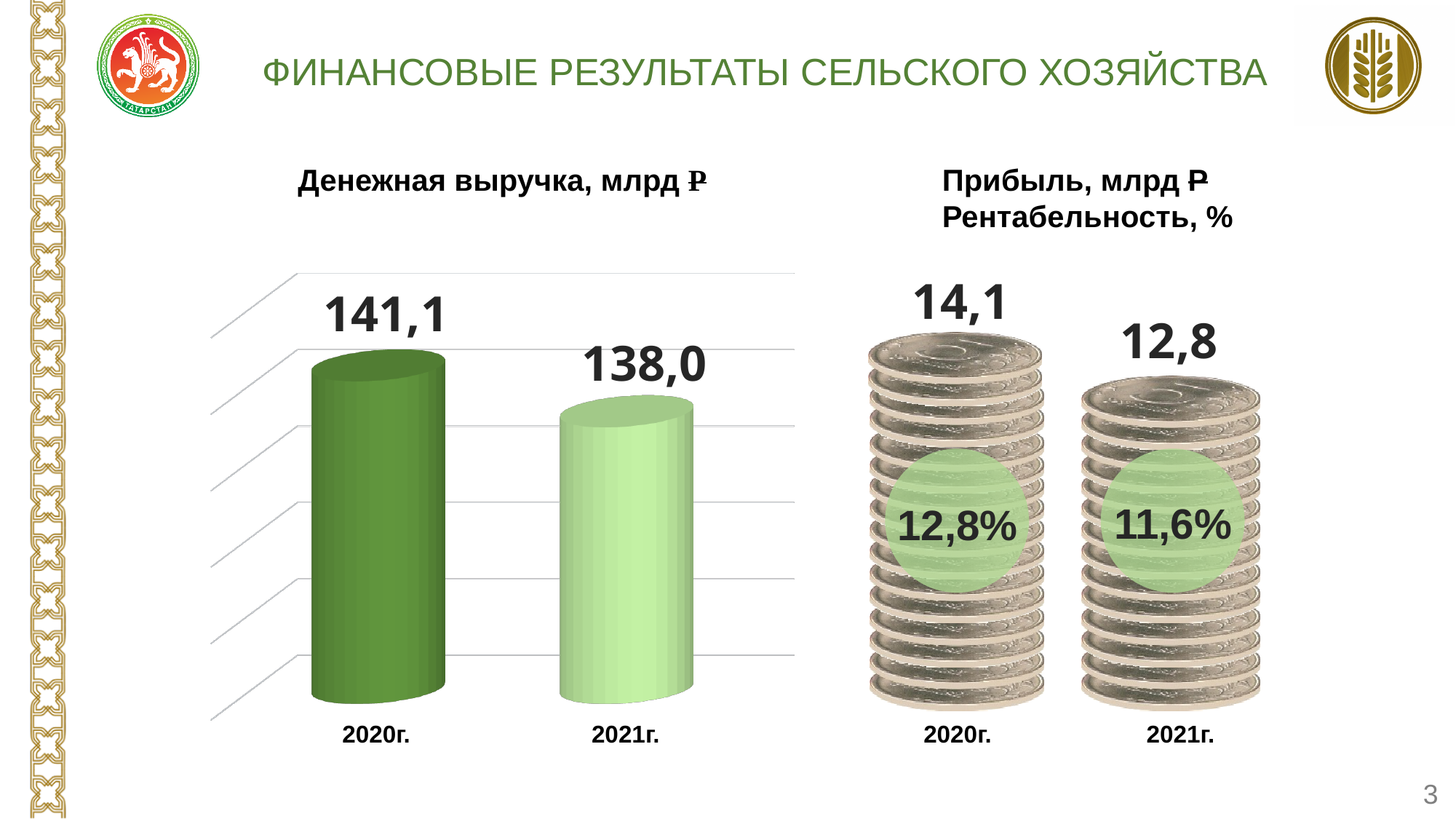
In the right-hand chart ("Прибыль, млрд ₽ / Рентабельность, %"), is the profitability (Рентабельность) for 2020г. larger or smaller than for 2021г.? larger In the right-hand chart ("Прибыль, млрд ₽ / Рентабельность, %"), what is the profitability (Рентабельность) for 2021г.? 11,6% In the right-hand chart ("Прибыль, млрд ₽ / Рентабельность, %"), what is the difference in profit (Прибыль) between 2020г. and 2021г.? 1,3 In the chart titled "Денежная выручка, млрд ₽", what is the difference between the 2020г. and 2021г. values? 3,1 In the chart titled "Денежная выручка, млрд ₽", which year has the higher value? 2020г. In the chart titled "Денежная выручка, млрд ₽", which year has the lower value? 2021г. What kind of chart is the one titled "Денежная выручка, млрд ₽"? bar chart In the chart titled "Денежная выручка, млрд ₽", do the values rise or fall from 2020г. to 2021г.? fall In the right-hand chart ("Прибыль, млрд ₽ / Рентабельность, %"), what is the profit (Прибыль) for 2020г.? 14,1 In the chart titled "Денежная выручка, млрд ₽", what is the value for 2020г.? 141,1 In the chart titled "Денежная выручка, млрд ₽", what is the value for 2021г.? 138,0 How many categories are shown in the chart titled "Денежная выручка, млрд ₽"? 2